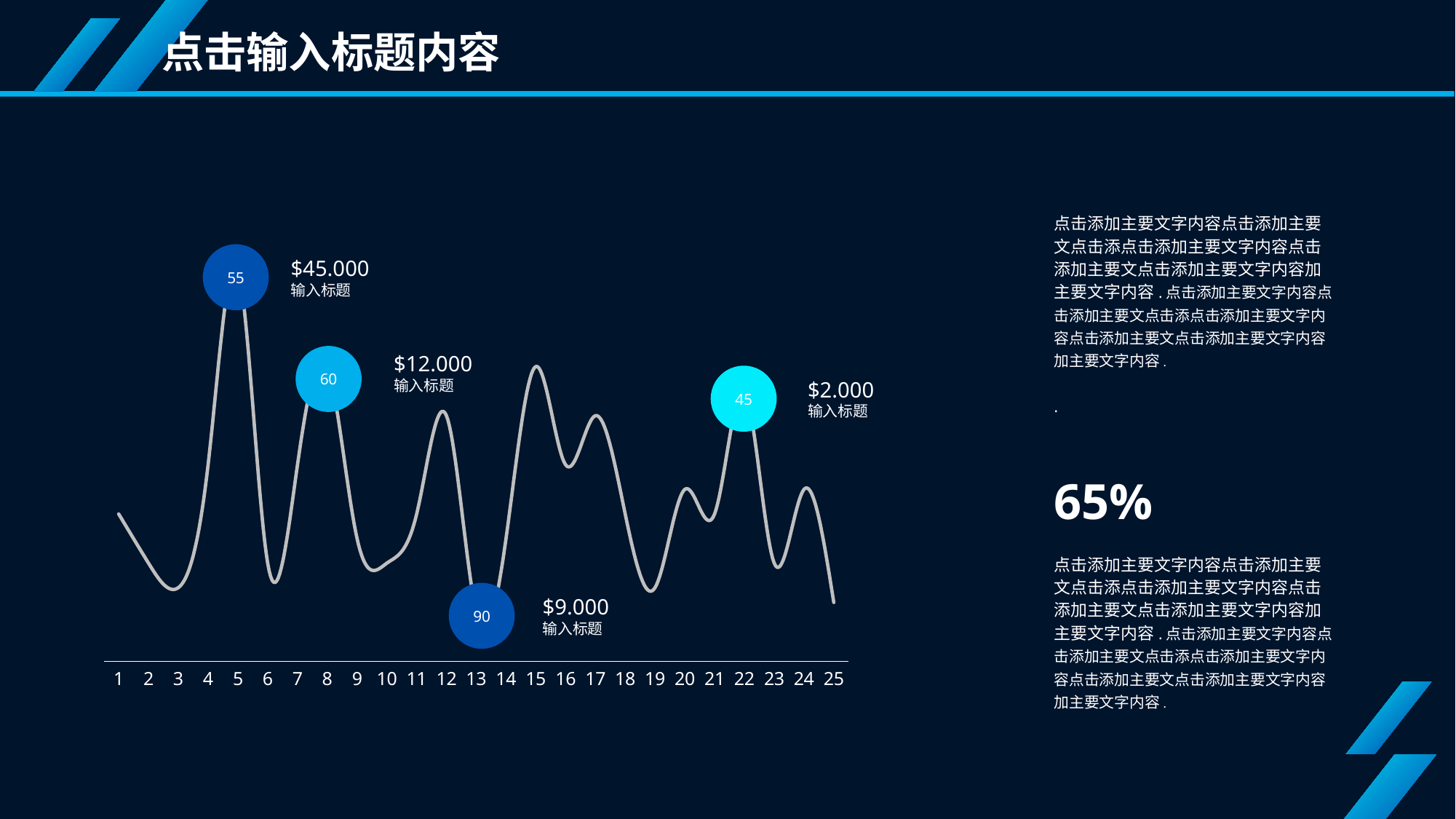
Which is higher on the line, the value at point 5 or the value at point 15? point 5 Which is higher on the line, the value at point 15 or the value at point 22? point 15 What dollar amount is printed next to the circle labelled 90? $9.000 How many points are labelled along the x axis of the chart? 25 Does the line rise or fall between point 3 and point 5? rise Which is higher on the line, the value at point 1 or the value at point 25? point 1 At which x-axis point does the line reach its highest peak? 5 What number is printed in the circle callout near the peak at point 5? 55 What kind of chart is shown on the slide? line chart Does the line rise or fall between point 22 and point 25? fall Does the line rise or fall between point 1 and point 3? fall